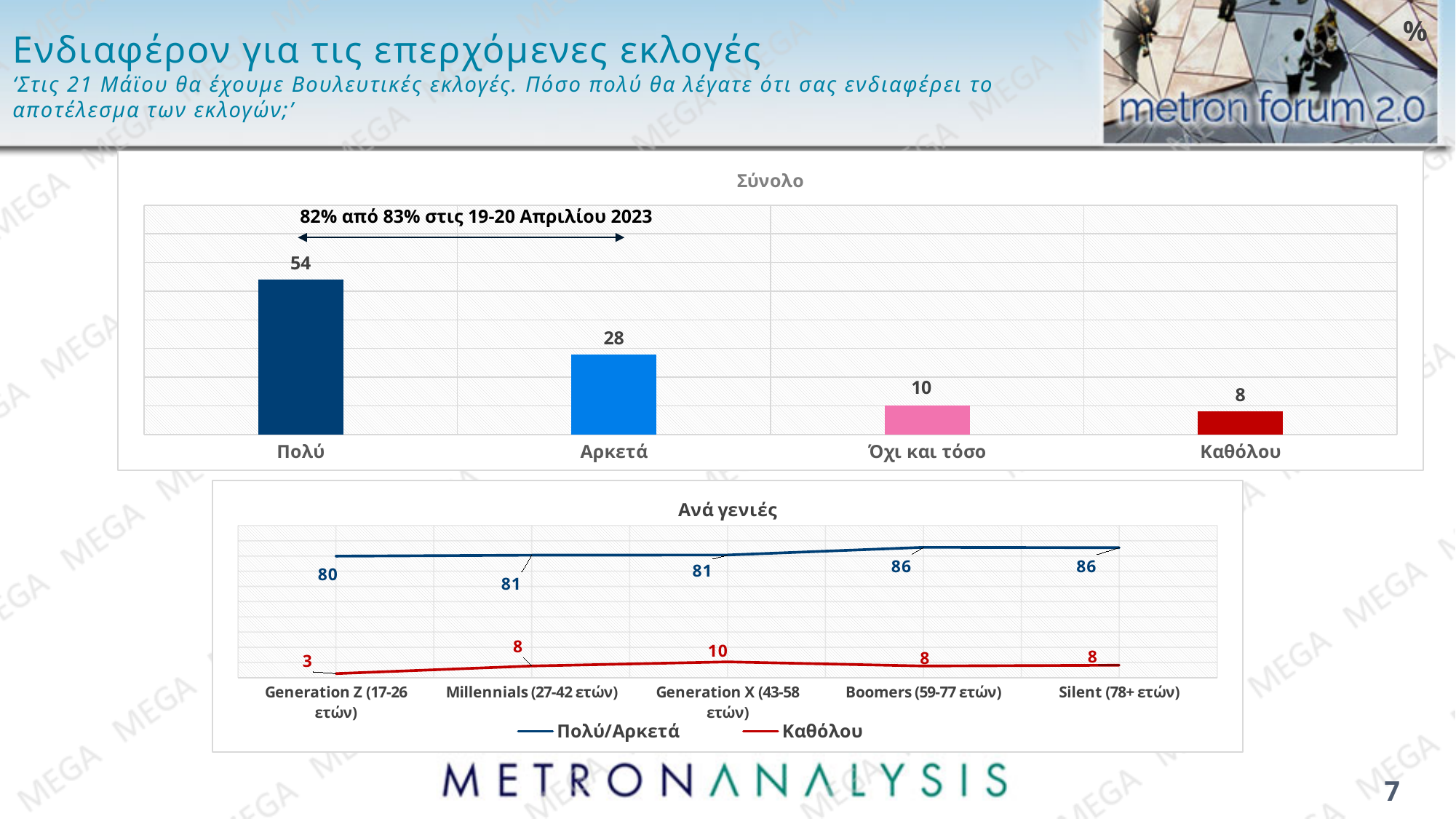
What kind of chart is the 'Ανά γενιές' chart? Line chart In the 'Σύνολο' chart, what is the value for 'Πολύ'? 54 In the 'Ανά γενιές' chart, how many series does the legend list? 2 In the 'Ανά γενιές' chart, what is the value of 'Καθόλου' for 'Generation X (43-58 ετών)'? 10 In the 'Ανά γενιές' chart, what is the value of 'Πολύ/Αρκετά' for 'Generation Z (17-26 ετών)'? 80 In the 'Σύνολο' chart, what is the total of 'Πολύ' and 'Αρκετά' according to the annotation above the bars? 82% In the 'Ανά γενιές' chart, what is the difference between the 'Πολύ/Αρκετά' values for 'Boomers (59-77 ετών)' and 'Generation Z (17-26 ετών)'? 6 In the 'Σύνολο' chart, what is the difference between the values for 'Πολύ' and 'Αρκετά'? 26 In the 'Σύνολο' chart, which category has the lowest value? Καθόλου What kind of chart is the 'Σύνολο' chart? Bar chart In the 'Σύνολο' chart, how many categories are shown? 4 In the 'Ανά γενιές' chart, which generation has the lowest 'Καθόλου' value? Generation Z (17-26 ετών)